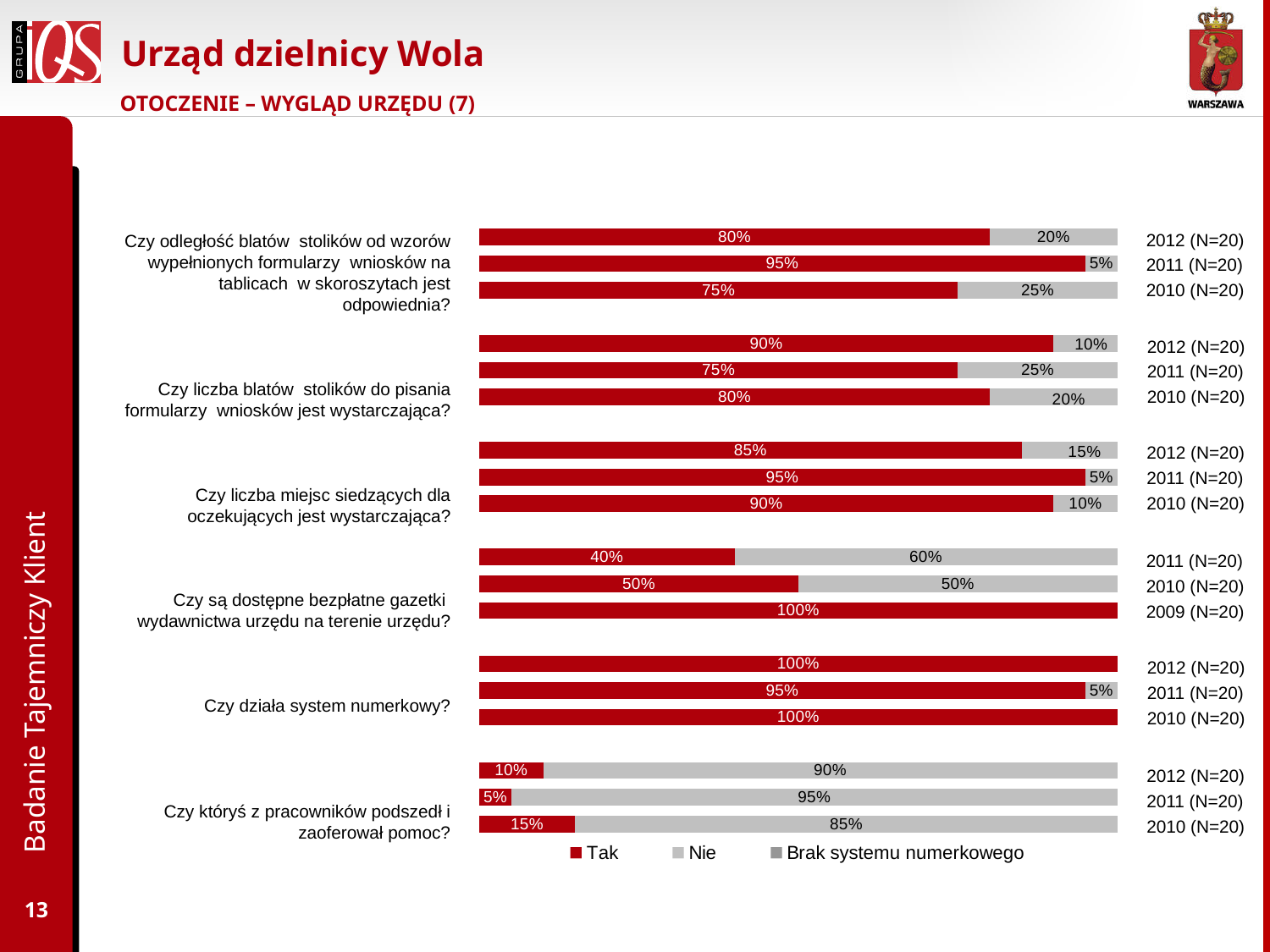
What share answered "Tak" in 2012 for "Czy odległość blatów stolików od wzorów wypełnionych formularzy wniosków na tablicach w skoroszytach jest odpowiednia?"? 80% What share answered "Nie" in 2010 for "Czy liczba blatów stolików do pisania formularzy wniosków jest wystarczająca?"? 20% What is the difference between the "Tak" share in 2011 and in 2010 for "Czy odległość blatów stolików od wzorów wypełnionych formularzy wniosków na tablicach w skoroszytach jest odpowiednia?"? 20% What share answered "Tak" in 2011 for "Czy są dostępne bezpłatne gazetki wydawnictwa urzędu na terenie urzędu?"? 40% For "Czy działa system numerkowy?", is the "Tak" share larger in 2012 or in 2011? 2012 What share answered "Tak" in 2010 for "Czy któryś z pracowników podszedł i zaoferował pomoc?"? 15% How many question groups are shown in the chart? 6 How many series does the legend list? 3 What is the sample size (N) shown for each bar? N=20 For "Czy liczba miejsc siedzących dla oczekujących jest wystarczająca?", which year has the highest "Tak" share? 2011 What kind of chart is shown on the slide? Stacked bar chart For "Czy liczba blatów stolików do pisania formularzy wniosków jest wystarczająca?", which year has the lowest "Tak" share? 2011